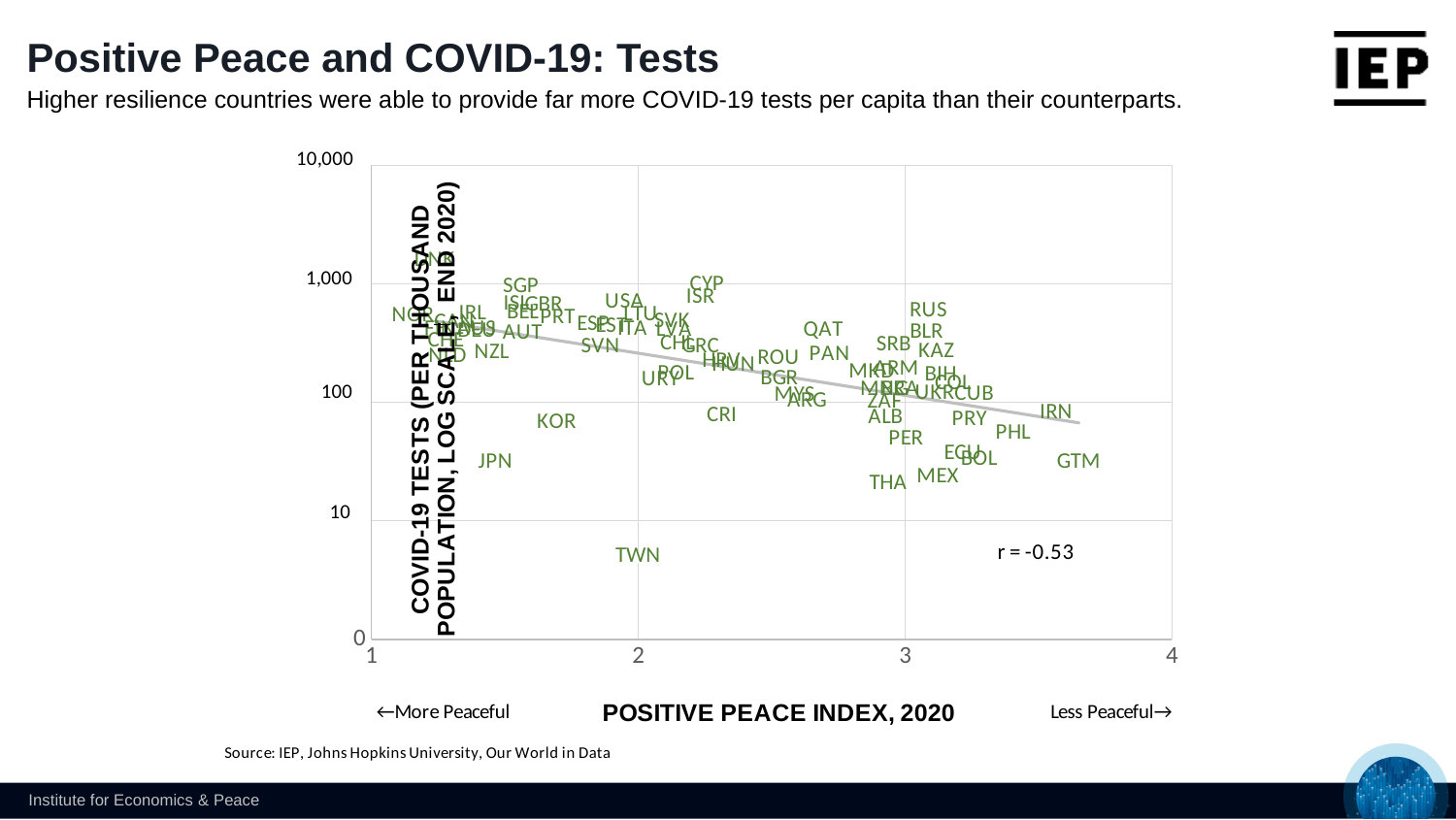
What is the title of the x axis of the chart? POSITIVE PEACE INDEX, 2020 What kind of chart is shown on the slide? scatter plot Which has more COVID-19 tests per thousand population, CYP or TWN? CYP Is the value of COVID-19 tests per thousand for TWN greater or less than 10? less Which country has the lowest COVID-19 tests per thousand population on the chart? TWN Is the value of COVID-19 tests per thousand for JPN greater or less than 100? less Is the Positive Peace Index value for GTM greater or less than 3? greater What correlation coefficient is printed on the chart? r = -0.53 As the Positive Peace Index increases along the x axis, do COVID-19 tests per thousand population generally rise or fall? fall